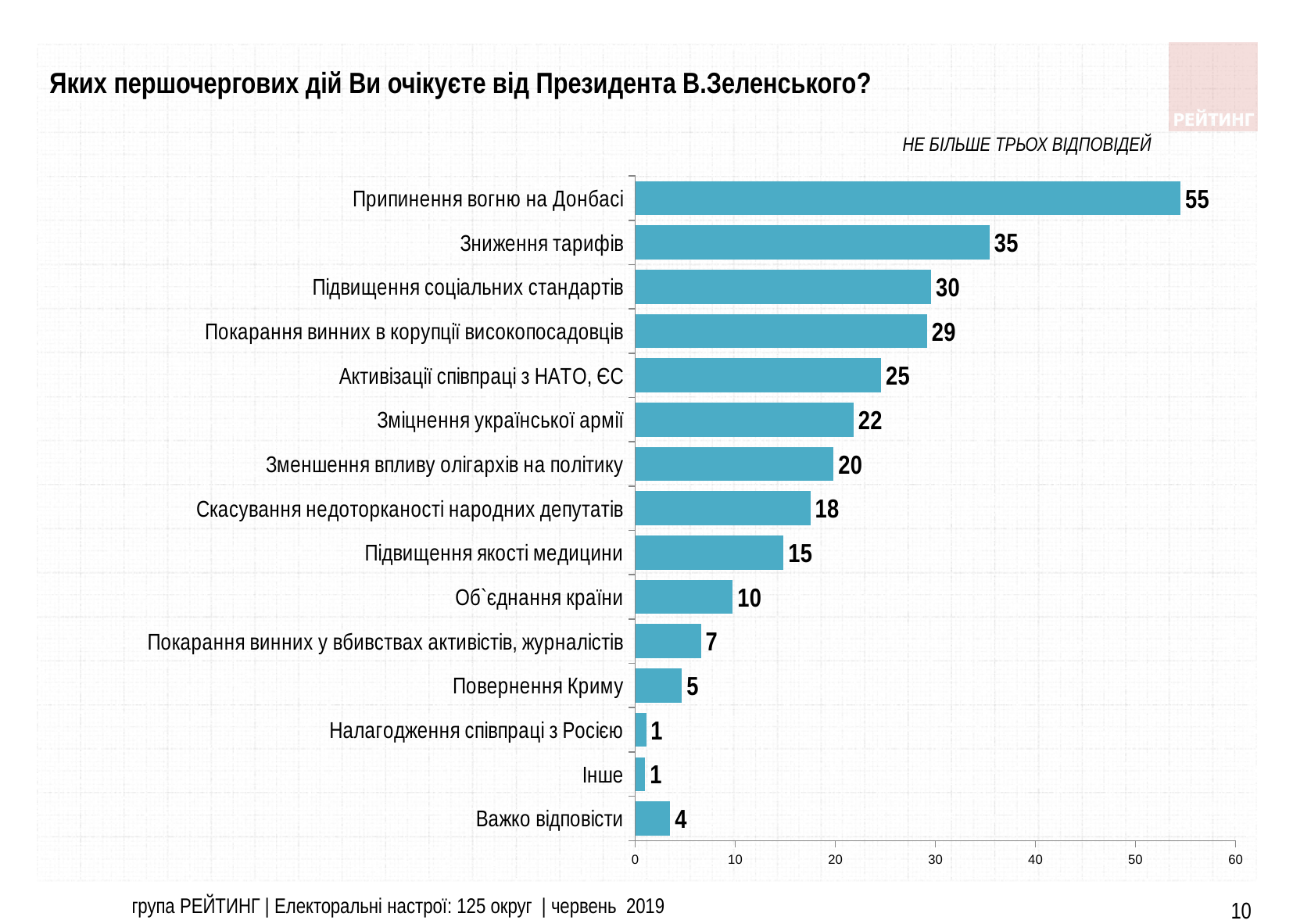
What kind of chart is shown on the slide? bar chart How many categories are shown in the chart? 15 Is the value for "Об`єднання країни" greater or less than 20? less What value is shown for "Важко відповісти"? 4 Which category has the highest value? Припинення вогню на Донбасі What value is shown for "Зниження тарифів"? 35 What is the difference between the values for "Припинення вогню на Донбасі" and "Зниження тарифів"? 20 What is the title of the chart? Яких першочергових дій Ви очікуєте від Президента В.Зеленського? Which is larger: the value for "Підвищення соціальних стандартів" or for "Активізації співпраці з НАТО, ЄС"? Підвищення соціальних стандартів What is the difference between the values for "Зміцнення української армії" and "Підвищення якості медицини"? 7 What value is shown for "Припинення вогню на Донбасі"? 55 What value is shown for "Повернення Криму"? 5